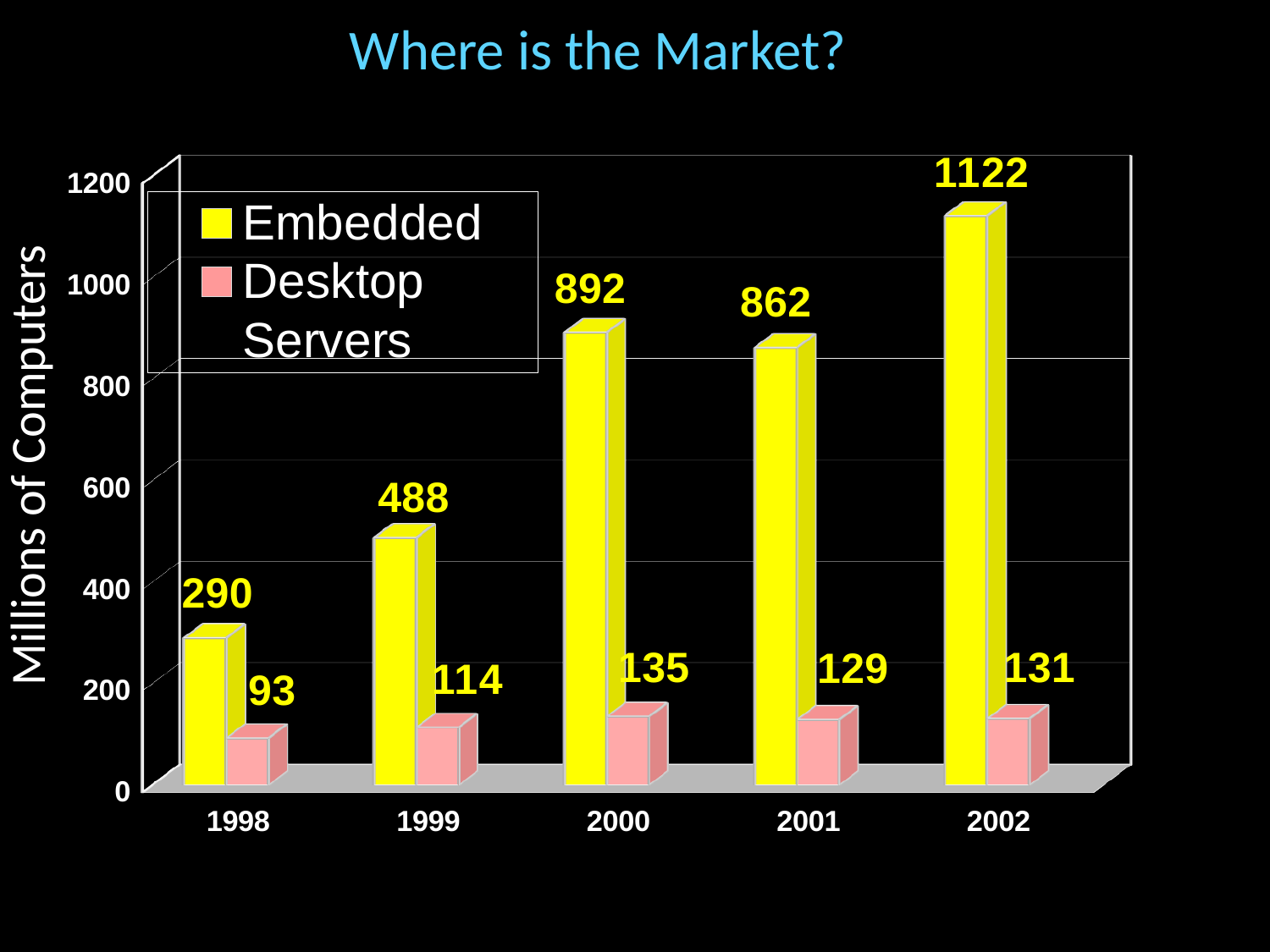
Which year has the highest Embedded value? 2002 How many series does the legend list? 3 What kind of chart is shown on the slide? Bar chart What is the Embedded value for 1999? 488 Which is larger, the Embedded value for 2000 or the Embedded value for 2001? 2000 What colour are the Embedded bars? Yellow What is the Embedded value for 2002? 1122 How many years are shown on the x axis? 5 What is the y-axis label of the chart? Millions of Computers